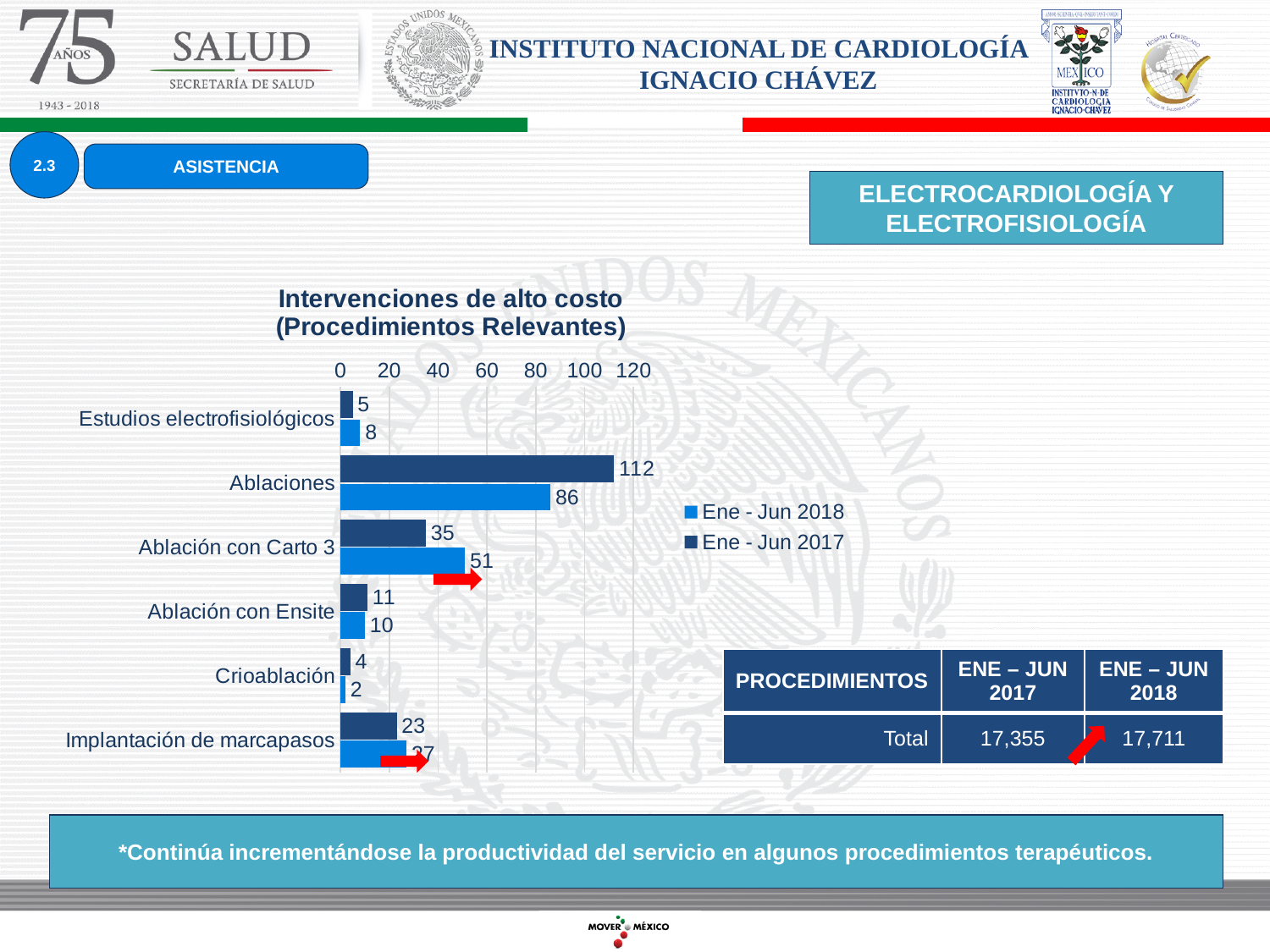
What is the value for Crioablación in the Ene - Jun 2018 series? 2 What kind of chart is shown on the slide? Bar chart What is the value for Ablación con Carto 3 in the Ene - Jun 2018 series? 51 What is the value for Estudios electrofisiológicos in the Ene - Jun 2017 series? 5 For Ablación con Carto 3, which series has the larger value, Ene - Jun 2017 or Ene - Jun 2018? Ene - Jun 2018 What is the value for Ablaciones in the Ene - Jun 2017 series? 112 What is the value for Ablaciones in the Ene - Jun 2018 series? 86 Which category has the lowest value in the Ene - Jun 2018 series? Crioablación What is the difference between the Ene - Jun 2017 and Ene - Jun 2018 values for Ablaciones? 26 How many series does the legend list? 2 Which category has the highest value in the Ene - Jun 2017 series? Ablaciones How many categories are shown on the chart? 6